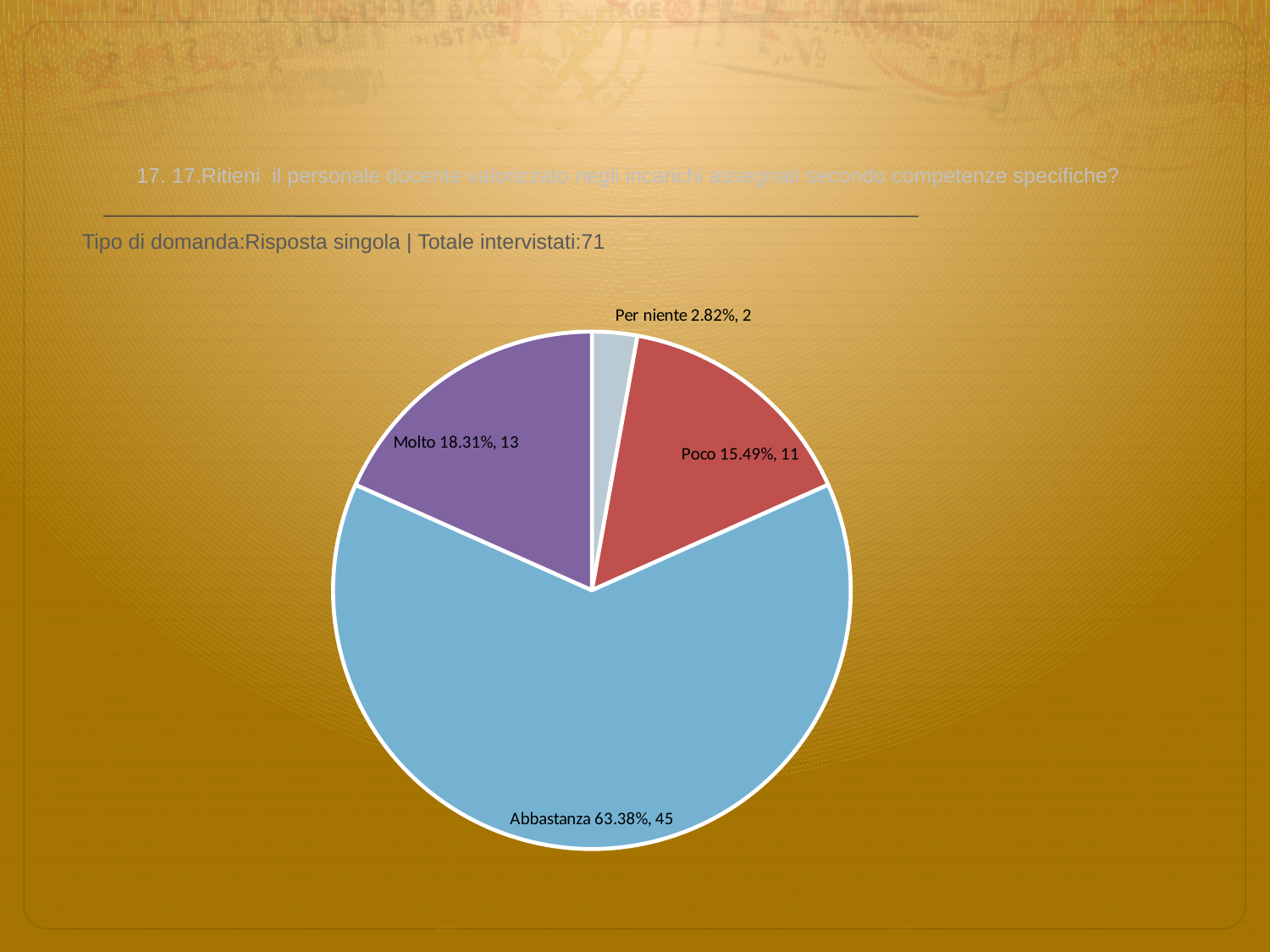
Which category has the smallest slice? Per niente What colour is the Abbastanza slice? light blue What percentage share does the Abbastanza slice have? 63.38% What is the total number of respondents shown in the pie chart? 71 How many respondents answered Poco? 11 What kind of chart is shown on the slide? pie chart What percentage share does the Per niente slice have? 2.82% What is the difference in respondent count between Abbastanza and Molto? 32 How many respondents answered Molto? 13 Which has more respondents, Molto or Poco? Molto How many slices does the pie chart have? 4 Which category has the largest slice? Abbastanza